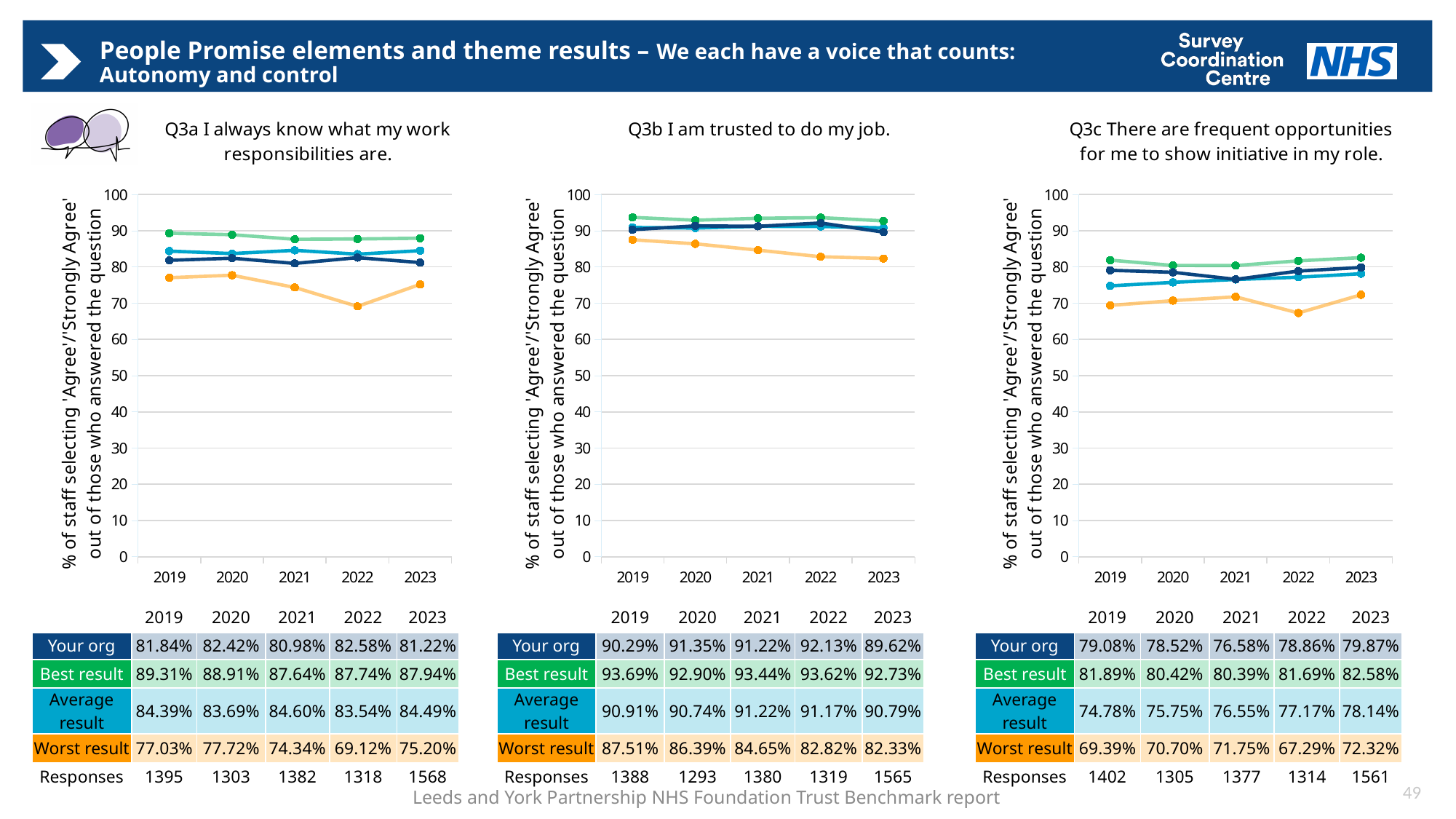
In the Q3a chart, what was the 'Your org' value in 2023? 81.22% In the Q3b chart, what was the 'Best result' value in 2021? 93.44% In the Q3c chart, what was the 'Worst result' value in 2022? 67.29% In the Q3c chart, how many responses were recorded in 2023? 1561 In the Q3b chart, which year had the highest 'Your org' value? 2022 How many years are plotted on the x axis of the Q3b chart? 5 In the Q3a chart, which is larger in 2021: the 'Your org' value or the 'Average result' value? Average result In the Q3b chart, does the 'Worst result' line rise or fall from 2019 to 2023? Fall In the Q3a chart, which year had the lowest 'Worst result' value? 2022 In the Q3c chart, what is the difference between the 'Best result' and 'Your org' values in 2023? 2.71% In the Q3c chart, is the 'Worst result' value for 2019 greater or less than 70? less What type of chart is used for Q3a? Line chart